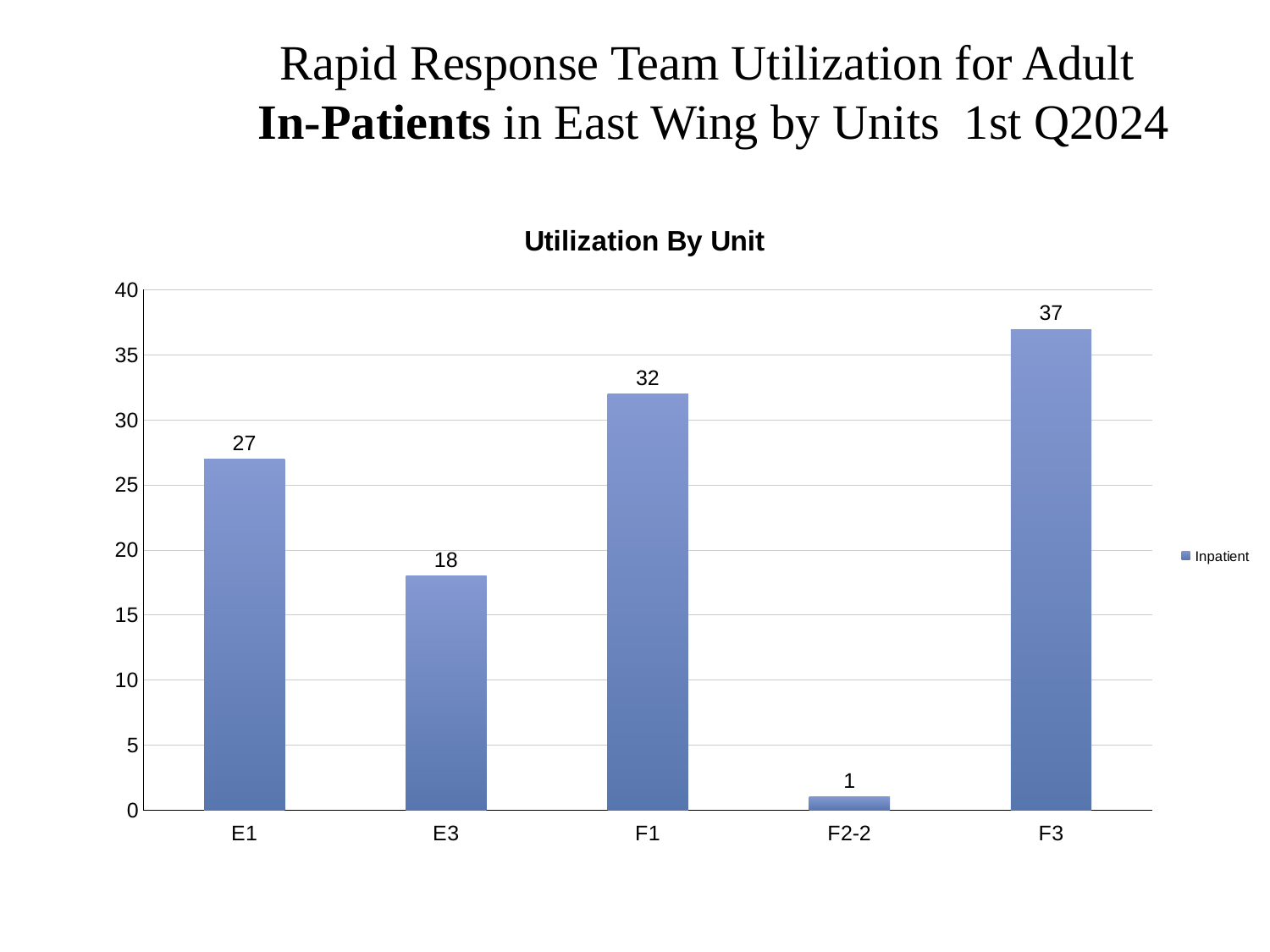
What is the value for E3? 18 Which unit has the highest value? F3 What kind of chart is this? bar chart What is the value for E1? 27 What is the title of the chart? Utilization By Unit What is the difference between the values for E1 and E3? 9 Is the value for F1 greater or less than 30? greater Which unit has the lowest value? F2-2 What is the value for F2-2? 1 What is the difference between the values for F3 and F1? 5 Which is larger, the value for E1 or the value for F1? F1 How many units are shown on the x axis? 5